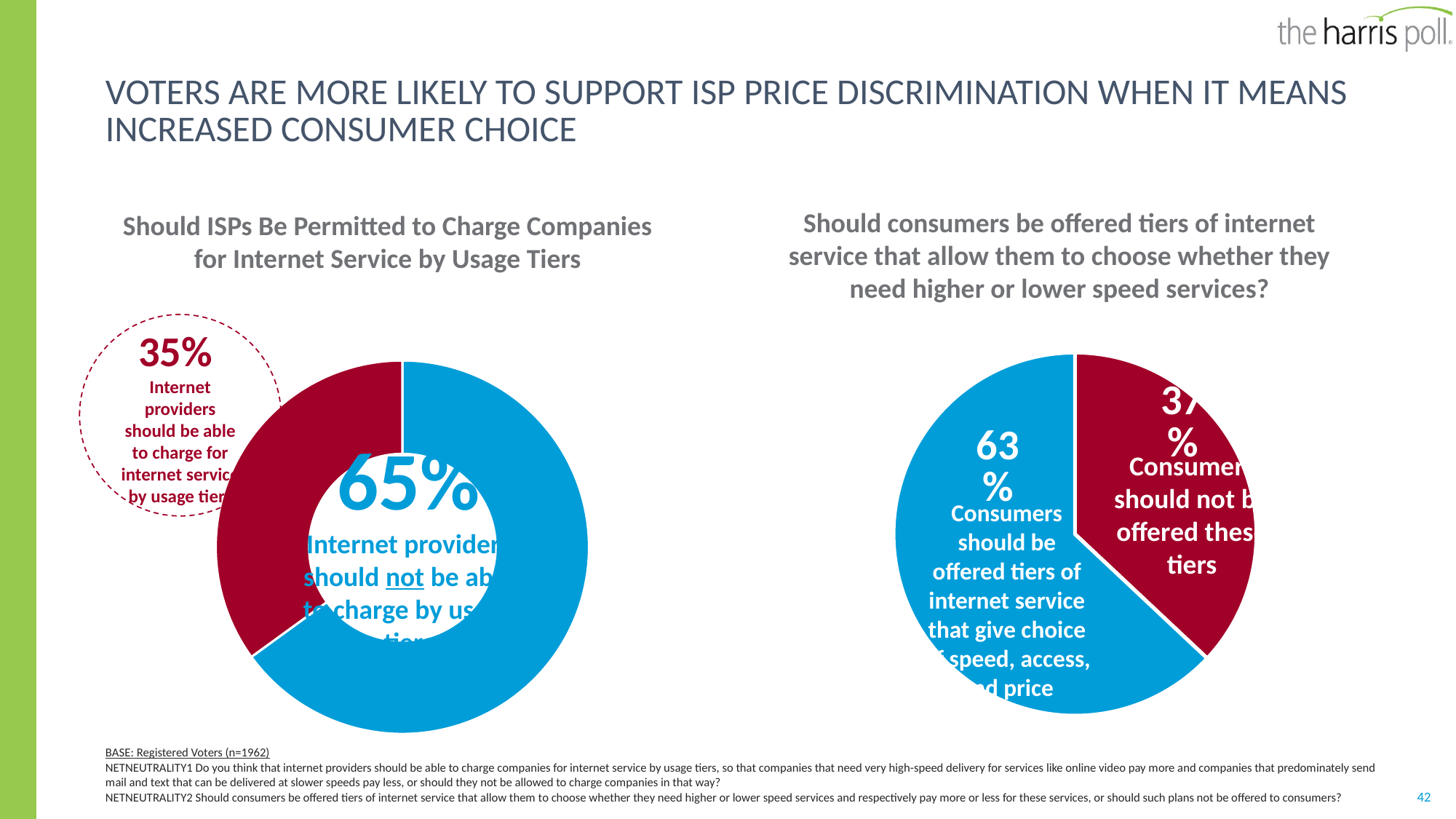
In the left chart, what is the difference in percentage points between the 'should not be able to charge' share and the 'should be able to charge' share? 30 percentage points In the right chart, 'Should consumers be offered tiers of internet service...', what percentage say consumers should be offered tiers of internet service that give choice of speed, access, and price? 63% In the left chart, which response has the larger share: providers should be able to charge by usage tiers, or providers should not be able to charge by usage tiers? Providers should not be able to charge by usage tiers What kind of chart is the right chart? Pie chart In the left chart, what percentage say internet providers should not be able to charge by usage tiers? 65% In the left chart, what colour is the segment representing 65%? Blue How many slices does the right chart have? 2 In the right chart, is the share for 'consumers should not be offered these tiers' greater or less than 50%? less In the left chart, what share of the doughnut does the red segment represent? 35% How many segments does the left chart have? 2 In the right chart, which response has the larger share: consumers should be offered tiers, or consumers should not be offered these tiers? Consumers should be offered tiers In the left chart, 'Should ISPs Be Permitted to Charge Companies for Internet Service by Usage Tiers', what percentage say internet providers should be able to charge for internet service by usage tiers? 35%